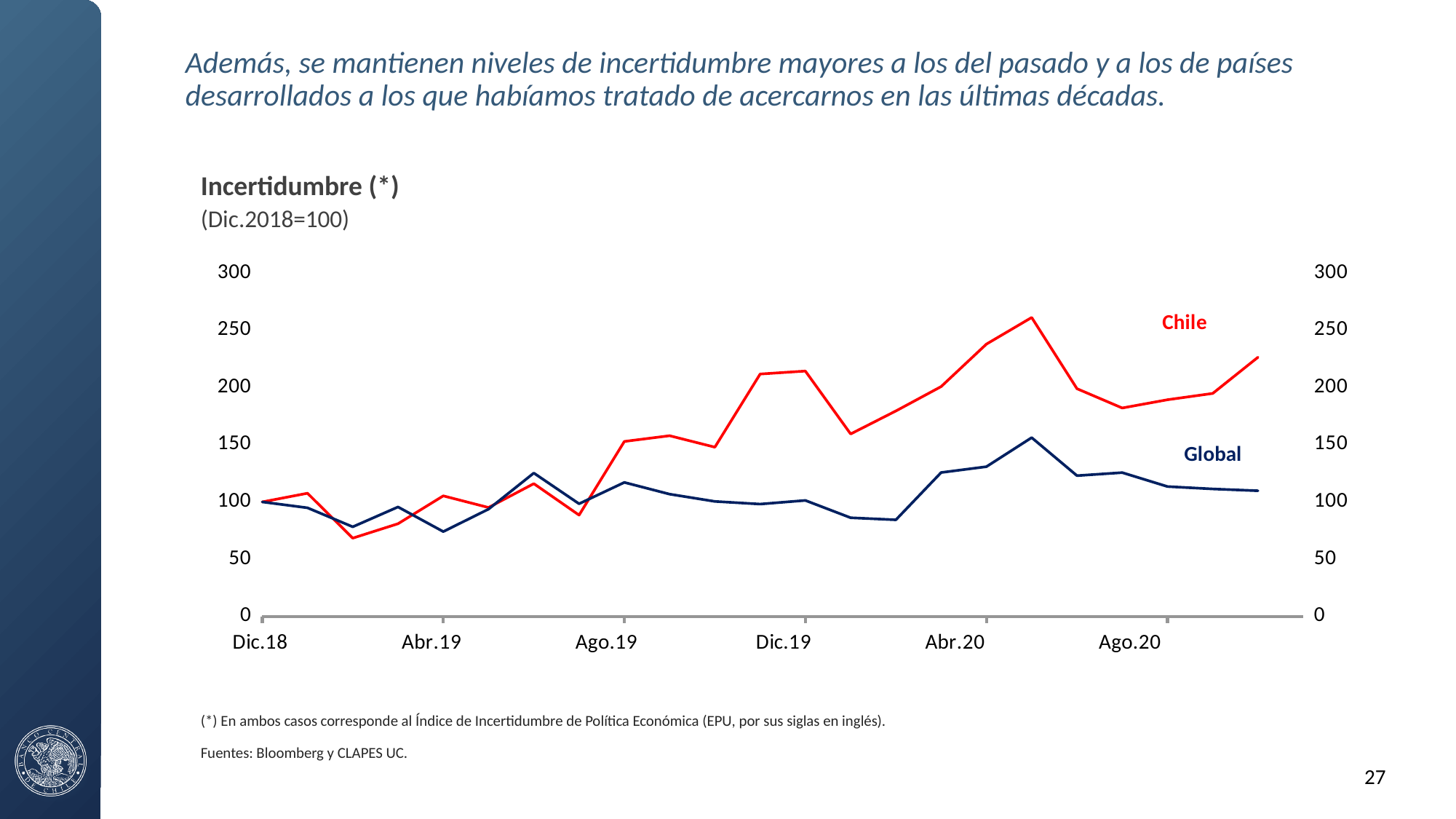
What kind of chart is shown on the slide? line chart Is the value for Global at Abr.20 greater or less than 100? greater What is the value of both series at Dic.18? 100 At Ago.20, which series has the larger value, Chile or Global? Chile Which series reaches the highest value in the chart? Chile Does the Chile series rise or fall overall from Dic.18 to the end of the chart? rise Which series is drawn in red? Chile Is the value for Global at Abr.19 greater or less than 100? less What is the title of the chart? Incertidumbre (*) How many series are plotted in the chart? 2 How many labelled dates are shown on the x axis? 6 Is the value for Chile at Ago.20 greater or less than 200? less